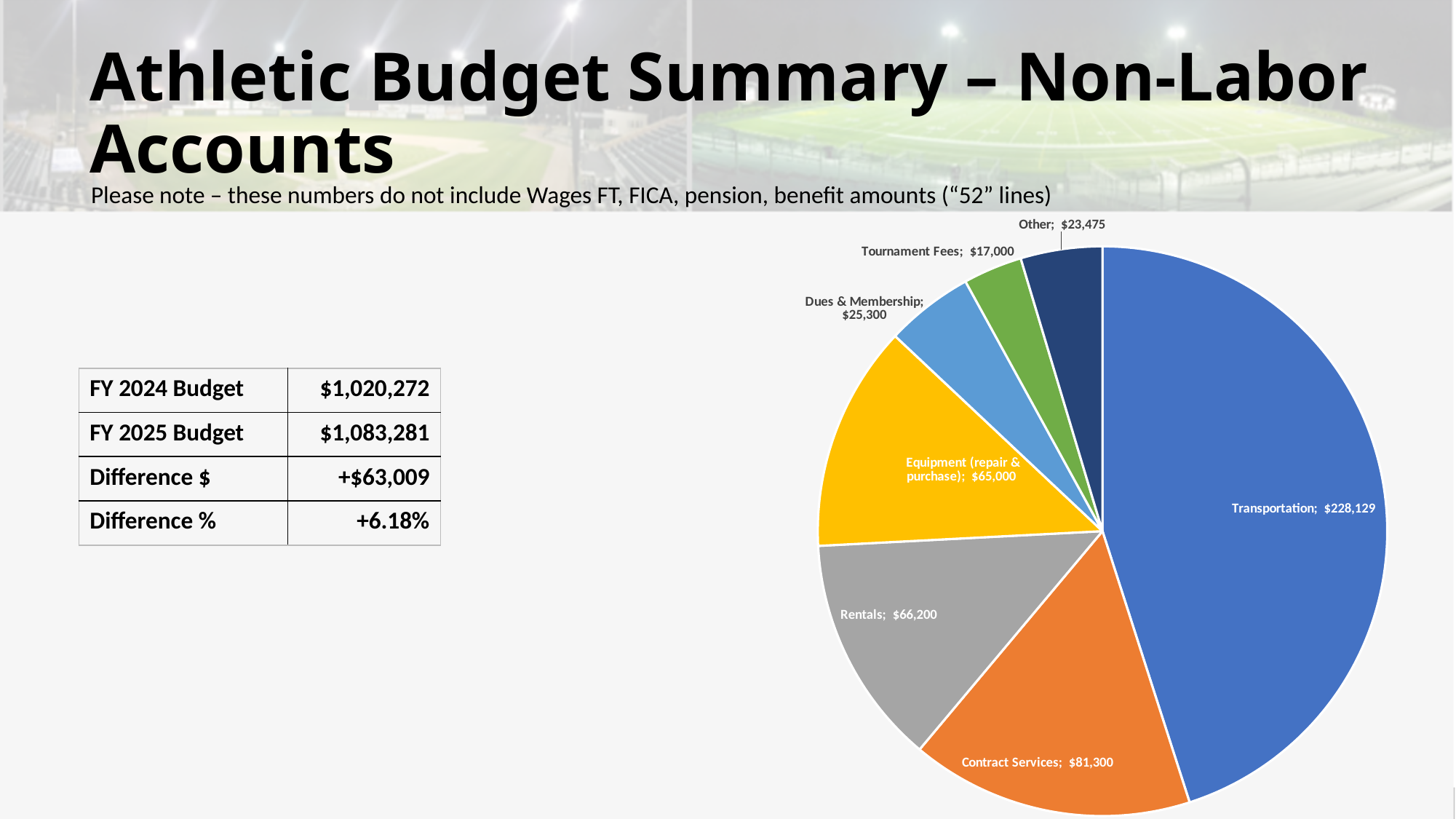
What is the value for Other in the pie chart? $23,475 Which category has the smallest slice in the pie chart? Tournament Fees What type of chart is shown on the slide? Pie chart What is the value for Dues & Membership in the pie chart? $25,300 What is the difference between Contract Services and Rentals in the pie chart? $15,100 How many slices does the pie chart have? 7 What is the value for Transportation in the pie chart? $228,129 What is the difference between Transportation and Contract Services in the pie chart? $146,829 What is the value for Contract Services in the pie chart? $81,300 Which category has the largest slice in the pie chart? Transportation What colour is the Transportation slice in the pie chart? Blue Which is larger in the pie chart, Rentals or Equipment (repair & purchase)? Rentals